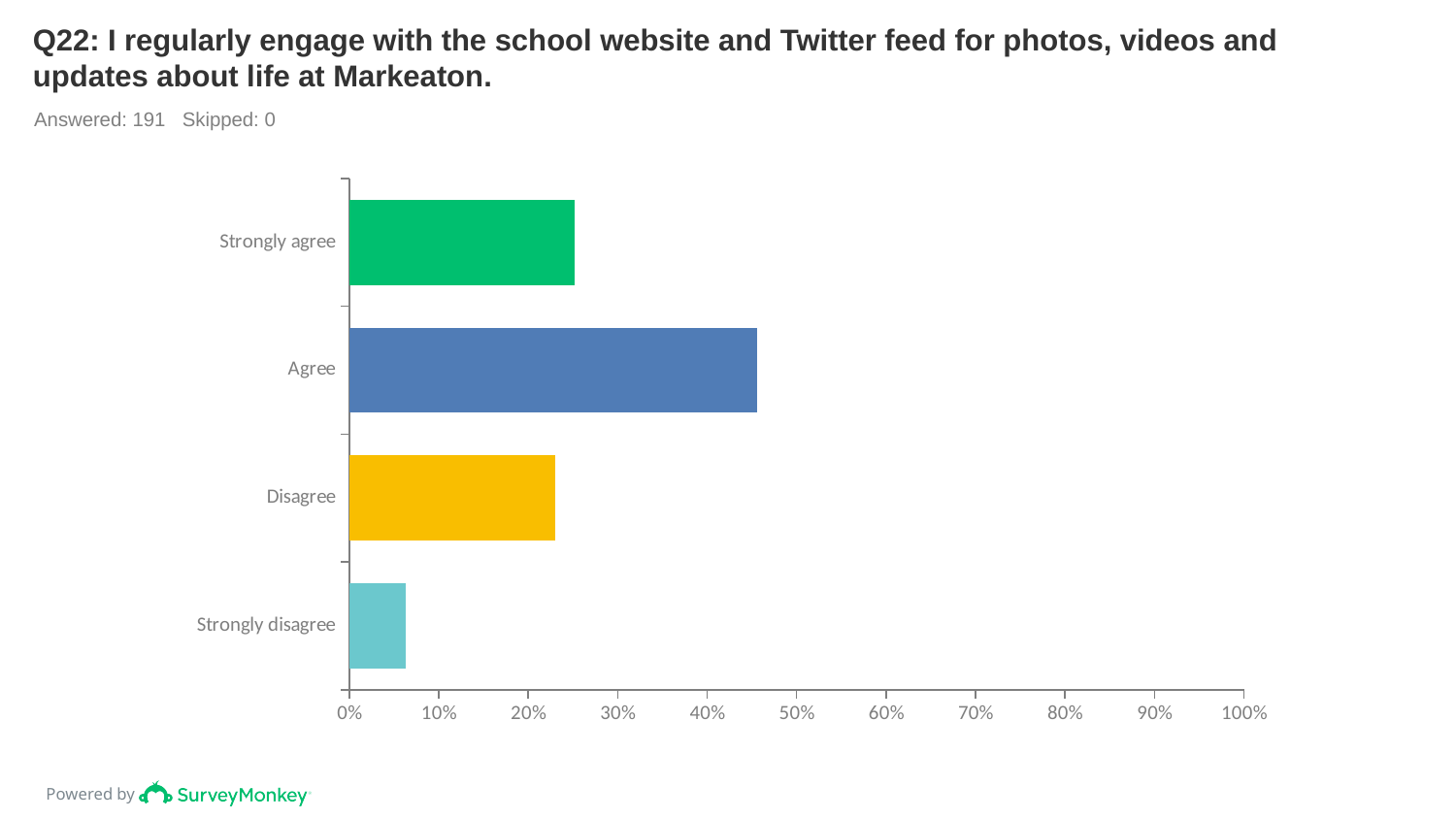
Which is larger, the value for Disagree or the value for Strongly disagree? Disagree Which is larger, the value for Agree or the value for Strongly agree? Agree How many respondents answered this question according to the slide? 191 Which response category has the highest value? Agree Is the value for Strongly disagree greater or less than 10%? less How many response categories are shown in the chart? 4 Which response category has the lowest value? Strongly disagree Is the value for Agree greater or less than 40%? greater What kind of chart is shown on the slide? bar chart Is the value for Strongly agree greater or less than 30%? less What is the question number shown in the chart title? Q22